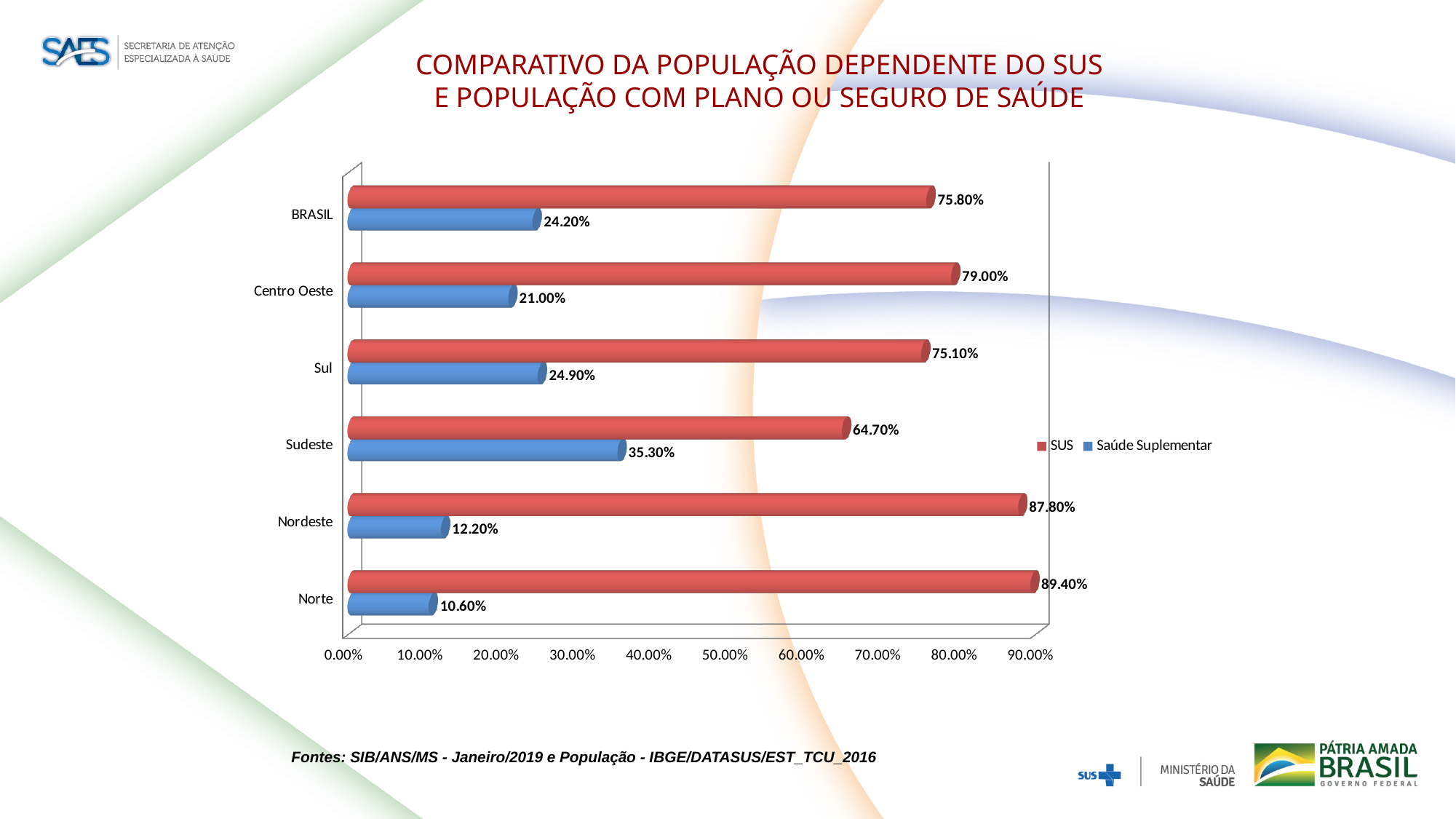
Which category has the lowest Saúde Suplementar value? Norte What is the difference between the SUS value for Nordeste and the SUS value for Sudeste? 23.10% How many series does the legend list? 2 What is the Saúde Suplementar value for BRASIL? 24.20% Which colour represents the SUS series? Red What is the SUS value for Centro Oeste? 79.00% How many categories are shown on the chart? 6 Which is larger, the Saúde Suplementar value for Sul or for Centro Oeste? Sul What is the Saúde Suplementar value for Sudeste? 35.30% What is the SUS value for Norte? 89.40% What kind of chart is shown on the slide? Bar chart Which category has the highest SUS value? Norte